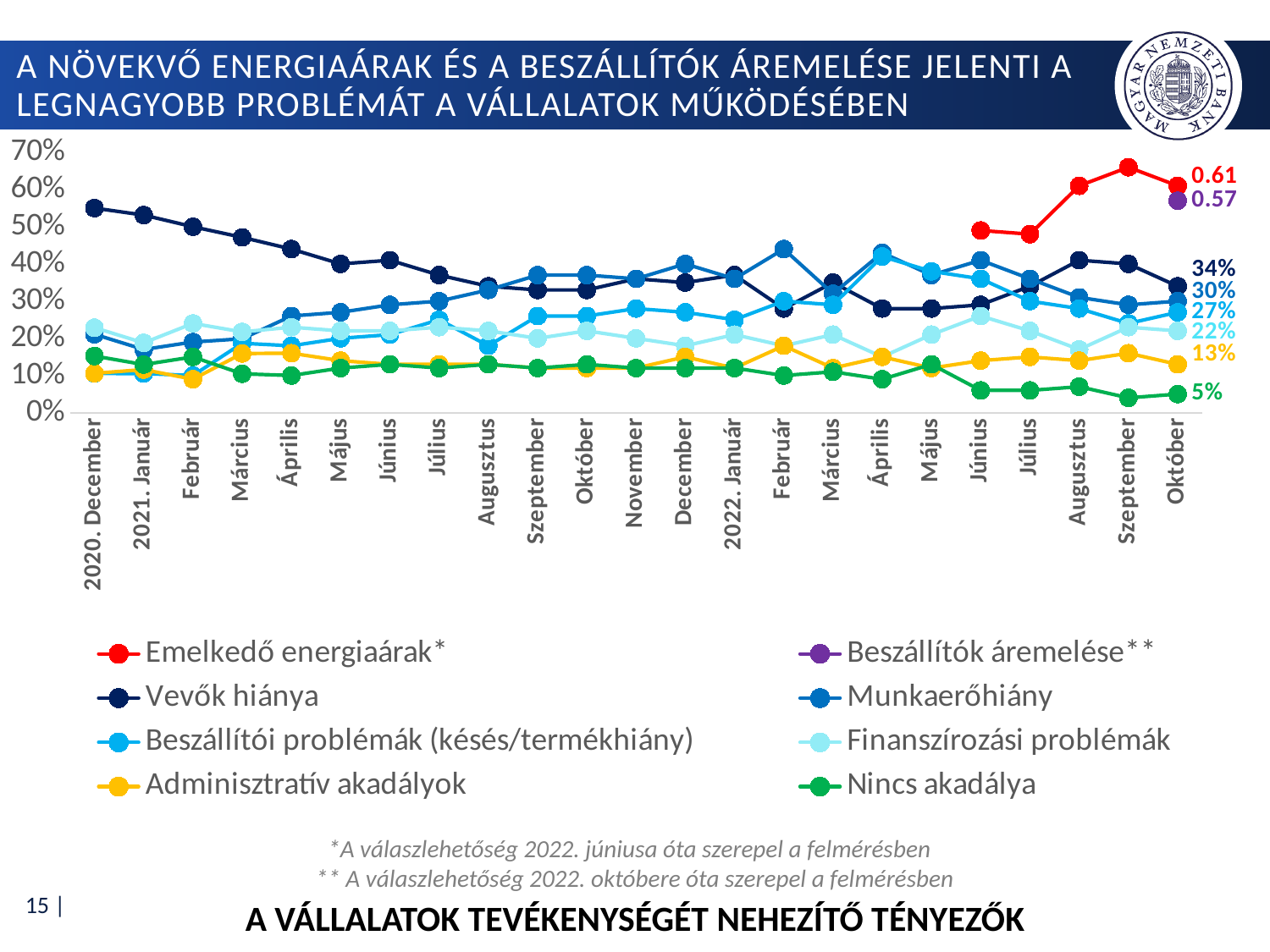
What is the value shown for Vevők hiánya at the last point (Október 2022)? 34% Which series has the highest value at the last point (Október 2022)? Emelkedő energiaárak How many series does the legend list? 8 What kind of chart is shown on the slide? line chart What is the value shown for Emelkedő energiaárak at the last point (Október 2022)? 0.61 Is the value for Vevők hiánya in 2020. December greater or less than 50%? greater Does the Vevők hiánya series rise or fall from 2020. December to Augusztus 2021? fall What is the value shown for Beszállítók áremelése at the last point (Október 2022)? 0.57 What is the difference between the Munkaerőhiány and Finanszírozási problémák values at the last point (Október 2022)? 8 percentage points What is the value shown for Nincs akadálya at the last point (Október 2022)? 5% Which series has the lowest value at the last point (Október 2022)? Nincs akadálya What is the value shown for Adminisztratív akadályok at the last point (Október 2022)? 13%